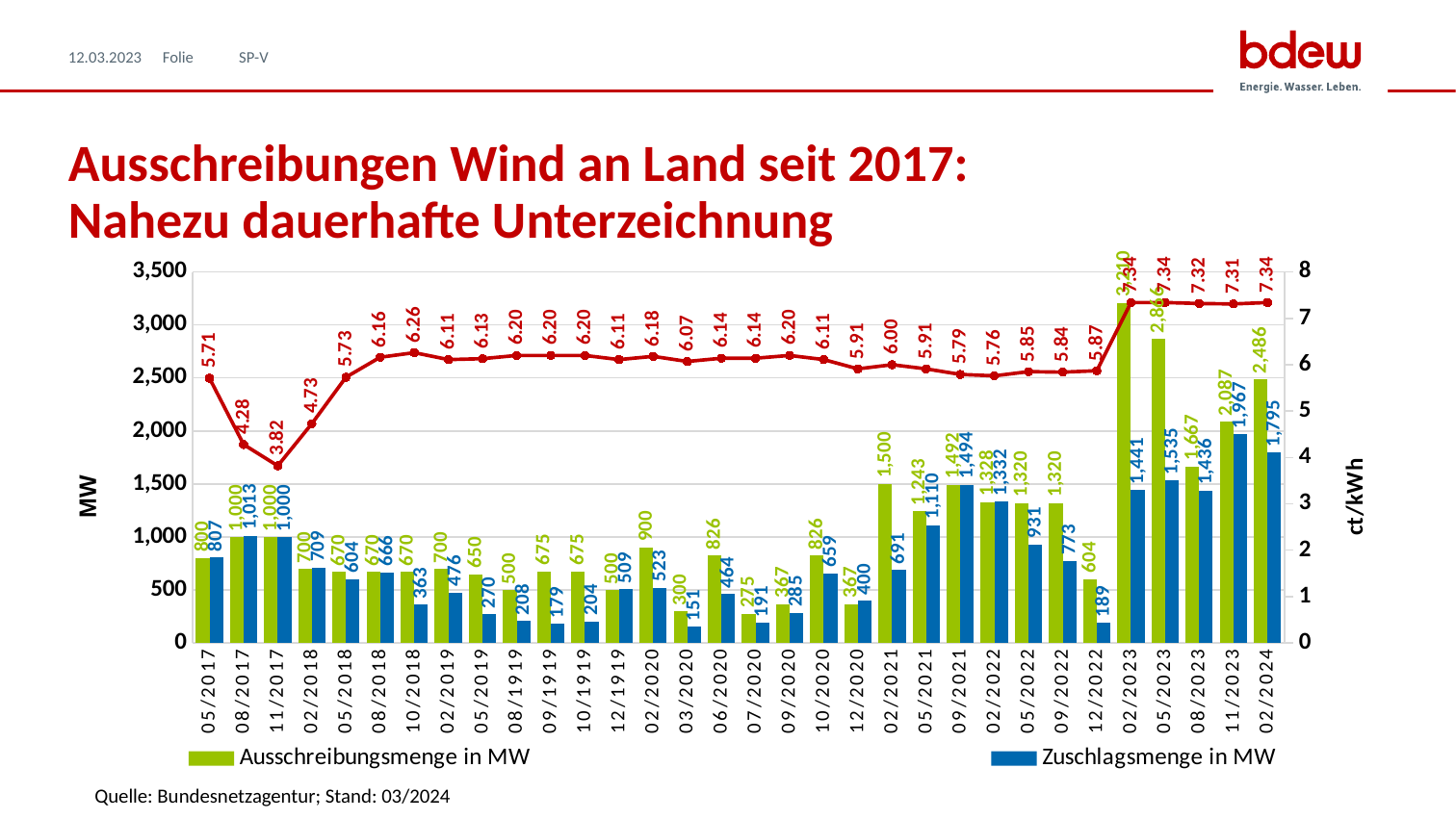
What is the Ausschreibungsmenge in MW for 02/2021? 1,500 What unit is shown on the right-hand axis? ct/kWh How many series does the legend list? 2 What is the difference between the Ausschreibungsmenge and the Zuschlagsmenge in 02/2023? 1,769 In which period is the Ausschreibungsmenge highest? 02/2023 In which period is the Zuschlagsmenge lowest? 03/2020 How many periods are shown on the x axis? 32 In 05/2021, which is larger: the Ausschreibungsmenge or the Zuschlagsmenge? Ausschreibungsmenge What value does the red line show for 11/2017? 3.82 What is the Zuschlagsmenge in MW for 11/2023? 1,967 In which period does the red line reach its lowest value? 11/2017 What is the Zuschlagsmenge in MW for 12/2022? 189